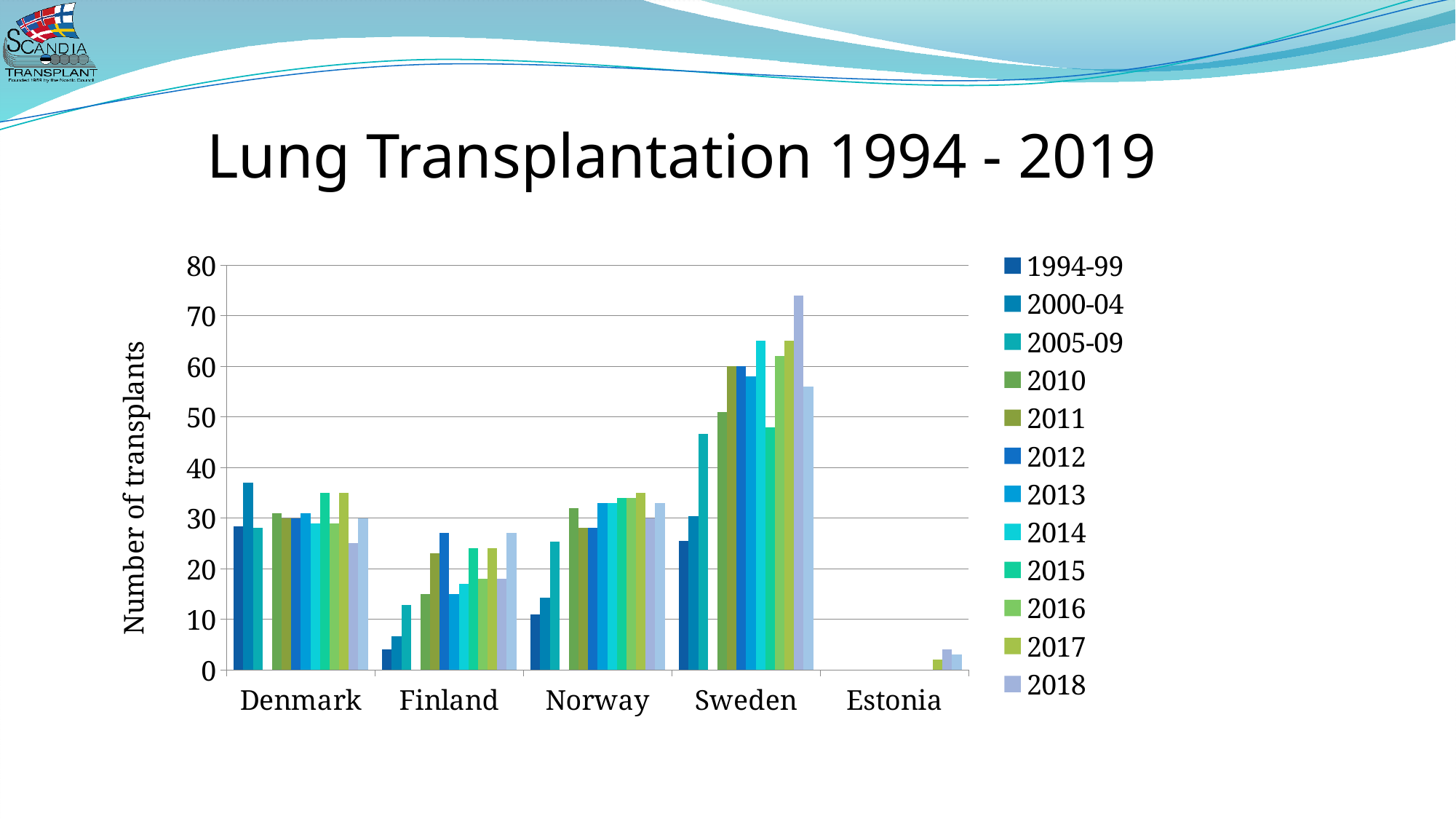
Which is larger, the 2018 value for Sweden or the 2018 value for Denmark? Sweden Is the value for Norway in 1994-99 greater or less than 20? less How many countries are shown on the x axis of the chart? 5 How many series does the chart's legend list? 12 Which country has the tallest bar in the chart? Sweden Is the value for Finland in 1994-99 greater or less than 10? less What is the label on the y axis of the chart? Number of transplants Which is larger, the 2000-04 value for Denmark or the 2000-04 value for Norway? Denmark Is the value for Denmark in 2000-04 greater or less than 30? greater Which country has the lowest number of transplants overall? Estonia What kind of chart is shown on the slide? bar chart